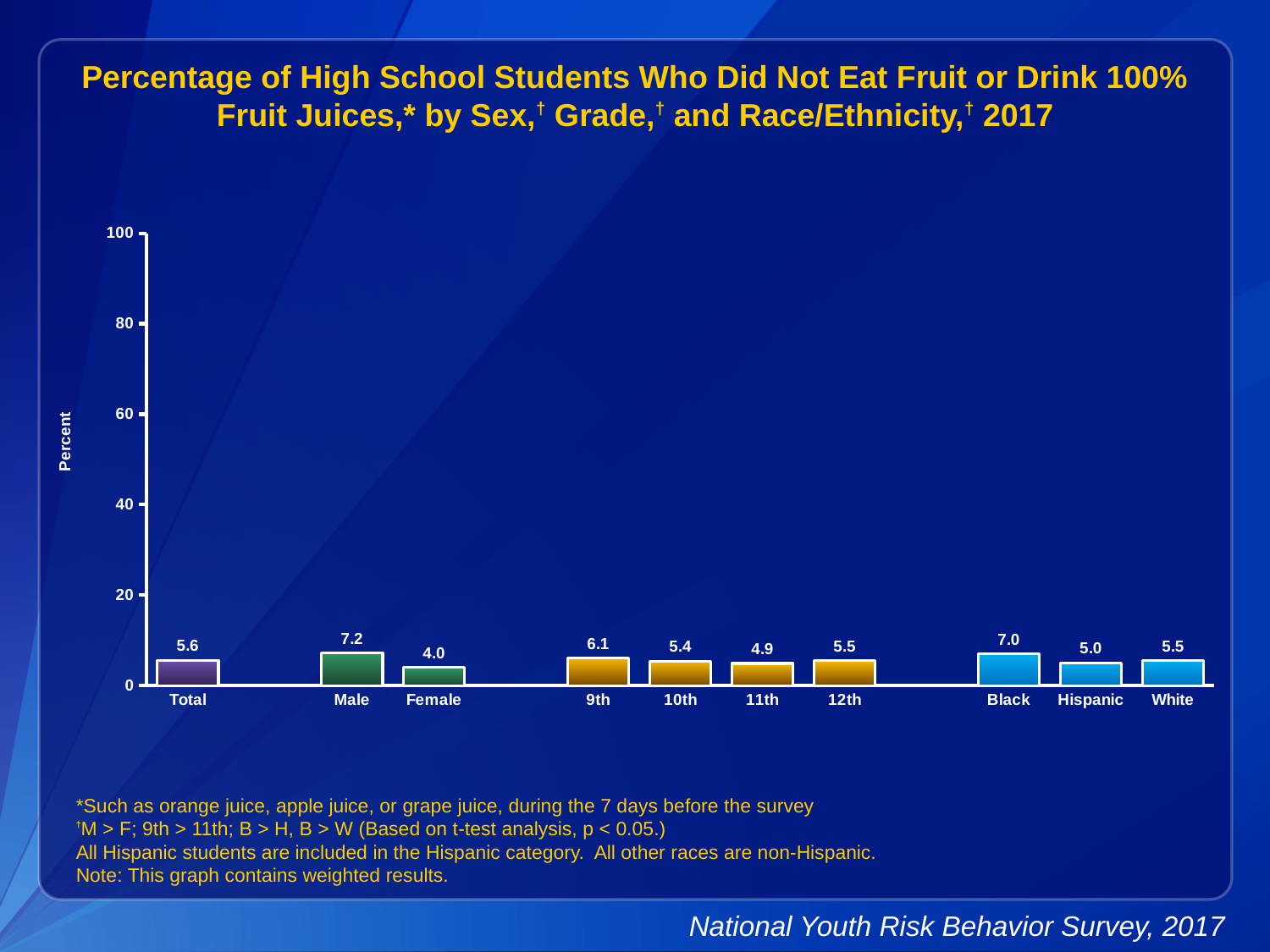
What is the label on the y axis? Percent What kind of chart is this? bar chart Which category has the highest value? Male What is the value for Total? 5.6 How many categories are shown on the x axis? 10 What is the value for Hispanic students? 5.0 Which category has the lowest value? Female What is the value for Male? 7.2 What is the value for 11th grade? 4.9 Is the value for 9th grade greater or less than 20? less Which is larger, the value for Black or the value for White? Black What is the difference between the values for Male and Female? 3.2